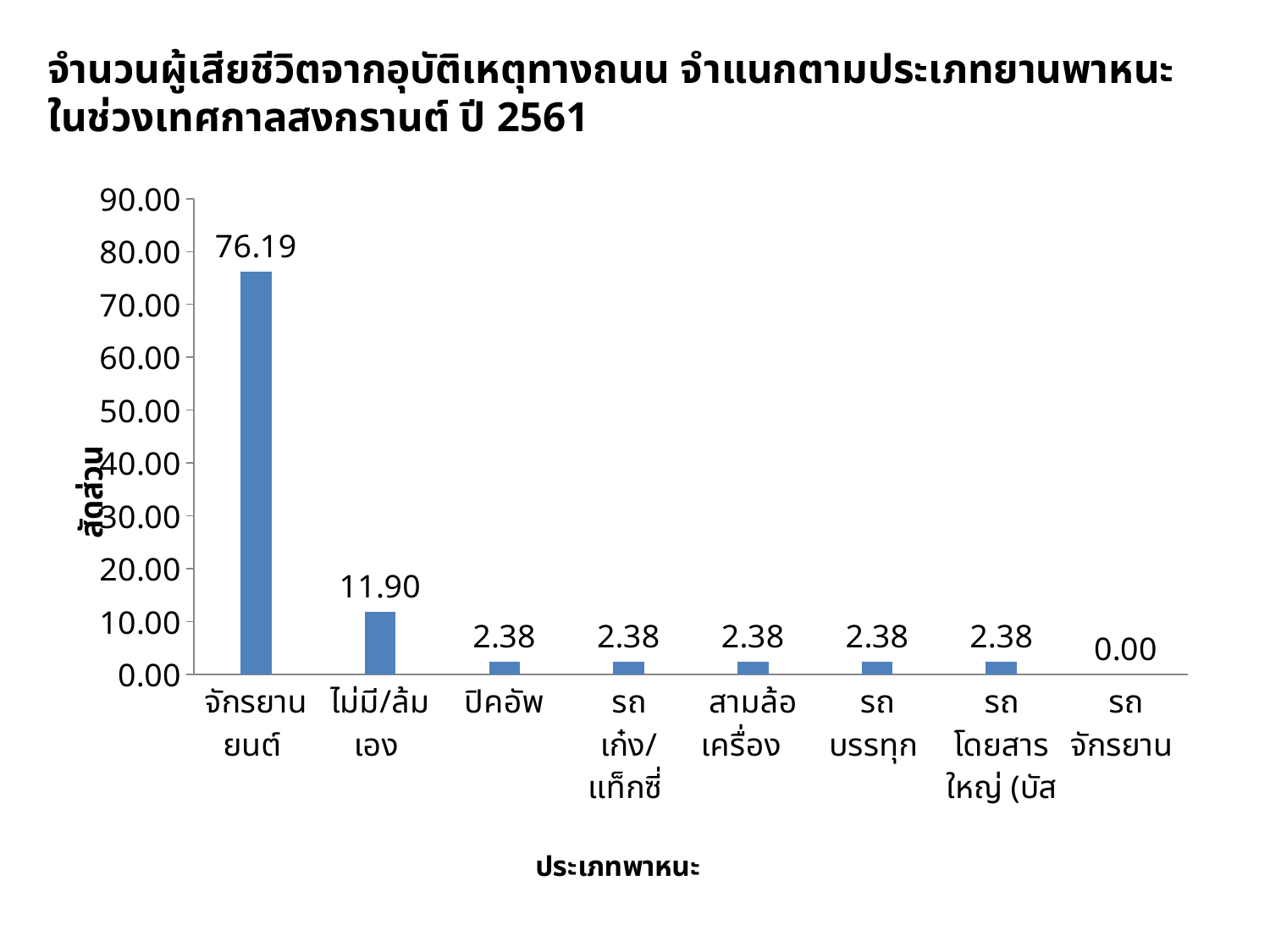
How many categories are shown on the x axis? 8 What is the value for จักรยานยนต์? 76.19 Which category has the highest value? จักรยานยนต์ What is the value for รถจักรยาน? 0.00 What is the value for ปิคอัพ? 2.38 What is the value for ไม่มี/ล้มเอง? 11.90 What is the label of the y axis? สัดส่วน Is the value for จักรยานยนต์ greater or less than 70.00? greater What kind of chart is shown on the slide? bar chart Which is larger, the value for ไม่มี/ล้มเอง or the value for รถบรรทุก? ไม่มี/ล้มเอง Which category has the lowest value? รถจักรยาน What is the difference between the values for จักรยานยนต์ and ไม่มี/ล้มเอง? 64.29